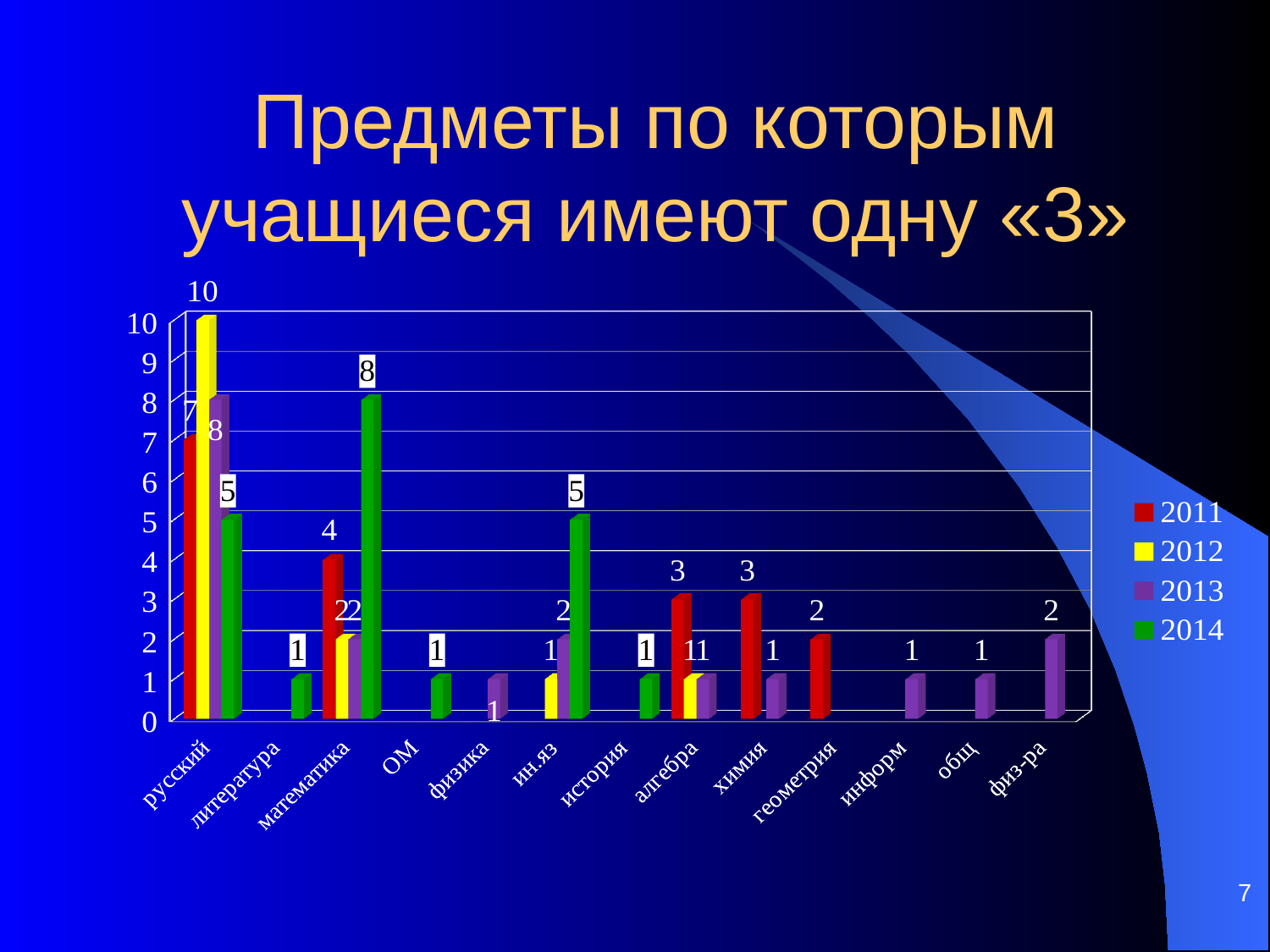
Which is larger in the 2014 series: математика or ин.яз? математика What is the difference between the 2012 and 2014 values for русский? 5 How many series does the legend list? 4 What is the value for русский in the 2012 series? 10 What kind of chart is shown on the slide? bar chart Which colour represents the 2014 series in the legend? green What is the value for математика in the 2014 series? 8 Which category and series has the tallest bar on the chart? русский, 2012 What is the value for физ-ра in the 2013 series? 2 Which category has the highest bar in the 2014 series? математика How many categories are shown on the x axis? 13 What is the value for химия in the 2011 series? 3